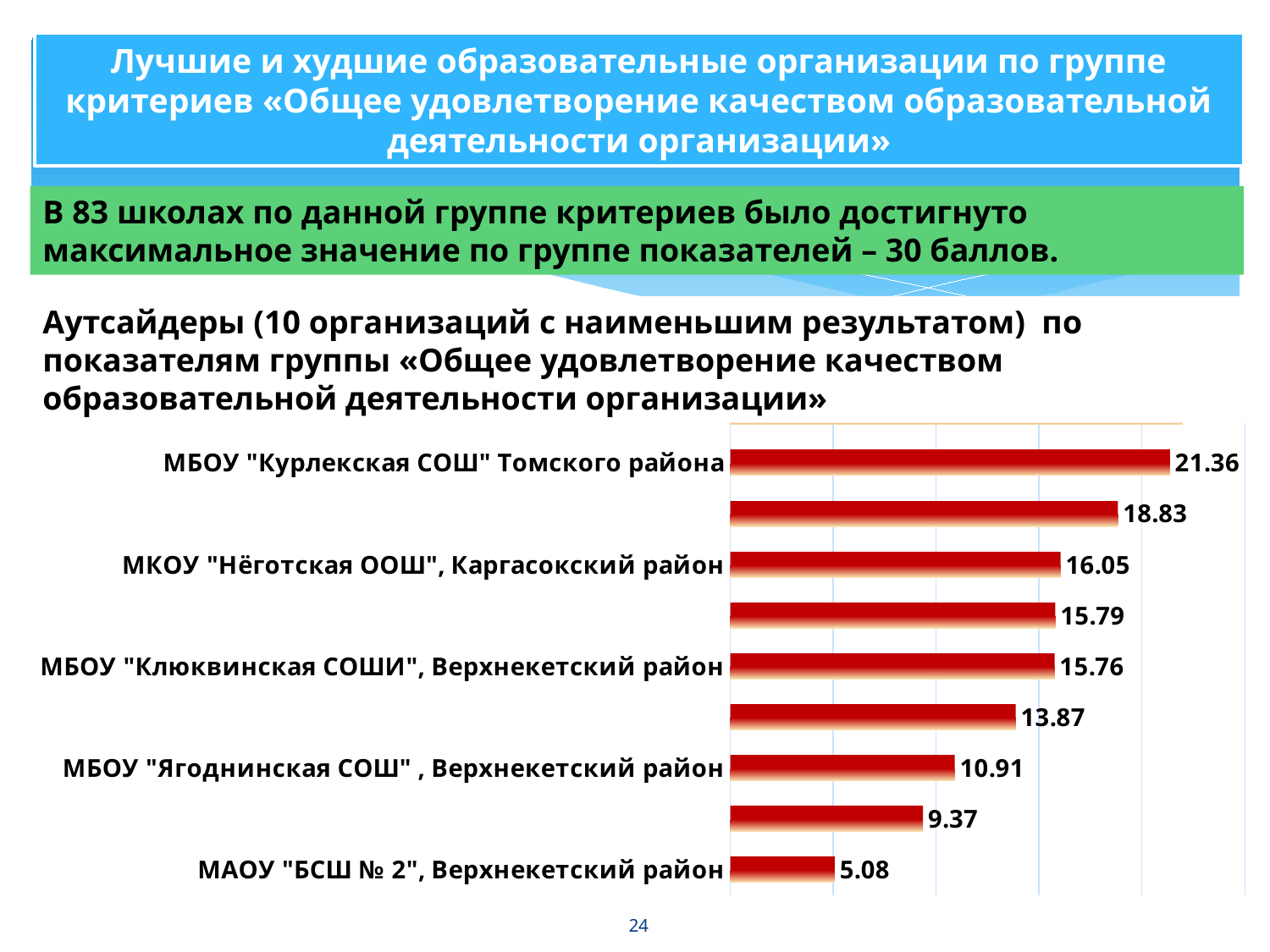
Which organization has the lowest value in the chart? МАОУ "БСШ № 2", Верхнекетский район What is the difference between the values for МБОУ "Курлекская СОШ" Томского района and МАОУ "БСШ № 2", Верхнекетский район? 16.28 Which has a larger value: МБОУ "Клюквинская СОШИ", Верхнекетский район or МБОУ "Ягоднинская СОШ", Верхнекетский район? МБОУ "Клюквинская СОШИ", Верхнекетский район How many bars are plotted in the chart? 9 What value is shown for МБОУ "Клюквинская СОШИ", Верхнекетский район? 15.76 What is the difference between the values for МКОУ "Нёготская ООШ", Каргасокский район and МБОУ "Ягоднинская СОШ", Верхнекетский район? 5.14 What value is shown for МБОУ "Курлекская СОШ" Томского района? 21.36 What kind of chart is shown on the slide? Bar chart What value is shown for МБОУ "Ягоднинская СОШ", Верхнекетский район? 10.91 Which organization has the highest value in the chart? МБОУ "Курлекская СОШ" Томского района What value is shown for МАОУ "БСШ № 2", Верхнекетский район? 5.08 What value is shown for МКОУ "Нёготская ООШ", Каргасокский район? 16.05